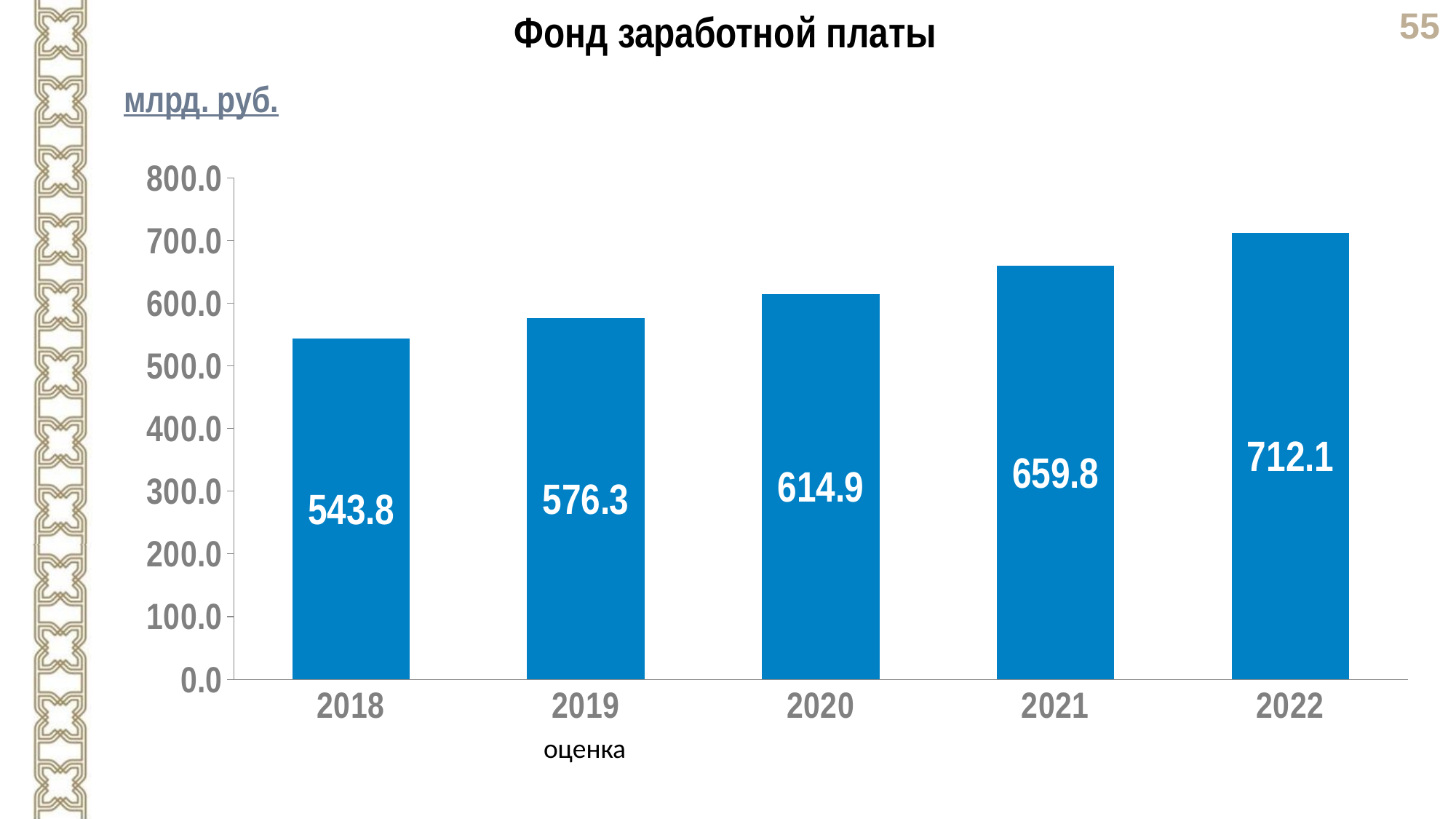
Do the values rise or fall from 2018 to 2022? rise What is the difference between the values for 2022 and 2018? 168.3 How many years are shown on the x axis? 5 What is the value for 2018? 543.8 What is the value for 2020? 614.9 Which year has the lowest value? 2018 What is the difference between the values for 2021 and 2020? 44.9 What kind of chart is shown on the slide? bar chart Which year has the highest value? 2022 Which is larger, the value for 2019 or the value for 2021? 2021 Is the value for 2019 greater or less than 600.0? less What is the value for 2022? 712.1